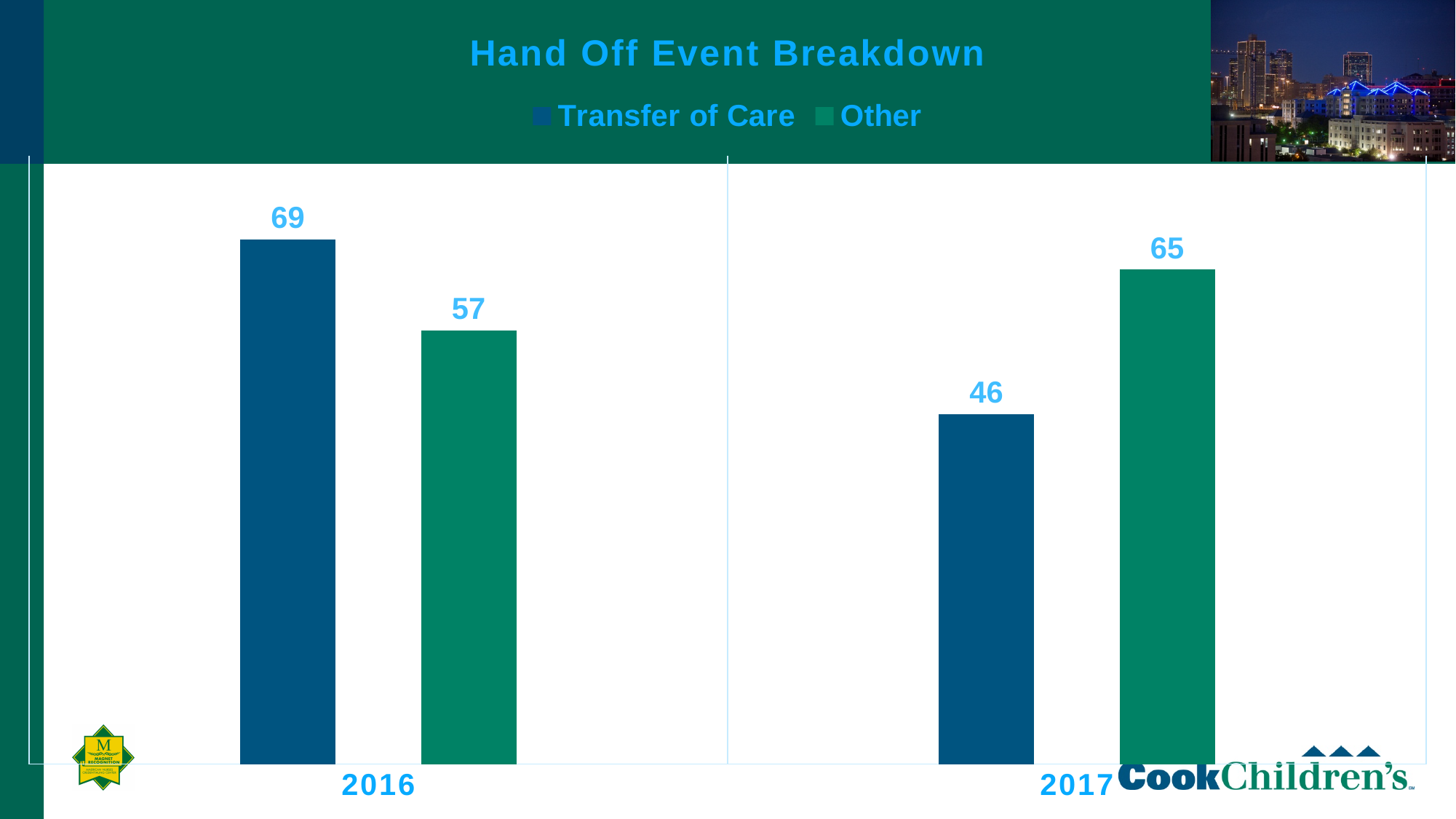
How many series does the legend list? 2 Which year has the highest Transfer of Care value? 2016 What kind of chart is shown on the slide? Bar chart Which year has the lowest Other value? 2016 What is the value for Other in 2016? 57 What is the difference between Transfer of Care in 2016 and 2017? 23 What is the value for Transfer of Care in 2016? 69 Which is larger in 2017, Transfer of Care or Other? Other What is the title of the chart? Hand Off Event Breakdown How many years are shown on the x axis? 2 What is the value for Other in 2017? 65 What is the value for Transfer of Care in 2017? 46